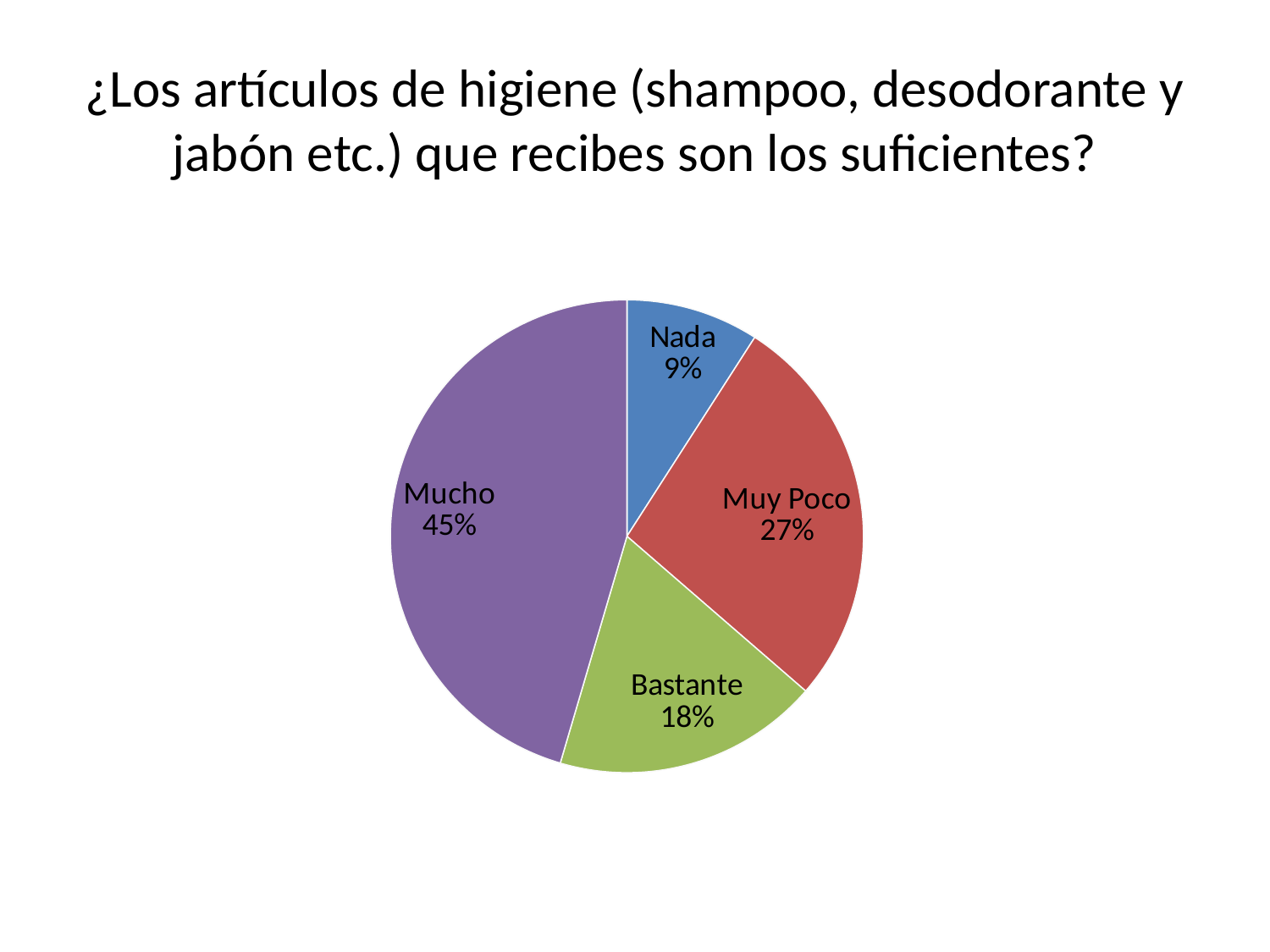
Which category has the largest slice of the pie? Mucho How many categories are shown in the pie chart? 4 What is the value shown for "Muy Poco"? 27% What is the difference in percentage points between "Bastante" and "Nada"? 9 What colour is the "Mucho" slice? purple What share of the pie does the "Mucho" slice represent? 45% What share of the pie does the "Nada" slice represent? 9% Which is larger, the slice for "Muy Poco" or the slice for "Bastante"? Muy Poco What is the value shown for "Bastante"? 18% What is the difference in percentage points between "Mucho" and "Muy Poco"? 18 Which category has the smallest slice of the pie? Nada What kind of chart is shown on the slide? pie chart